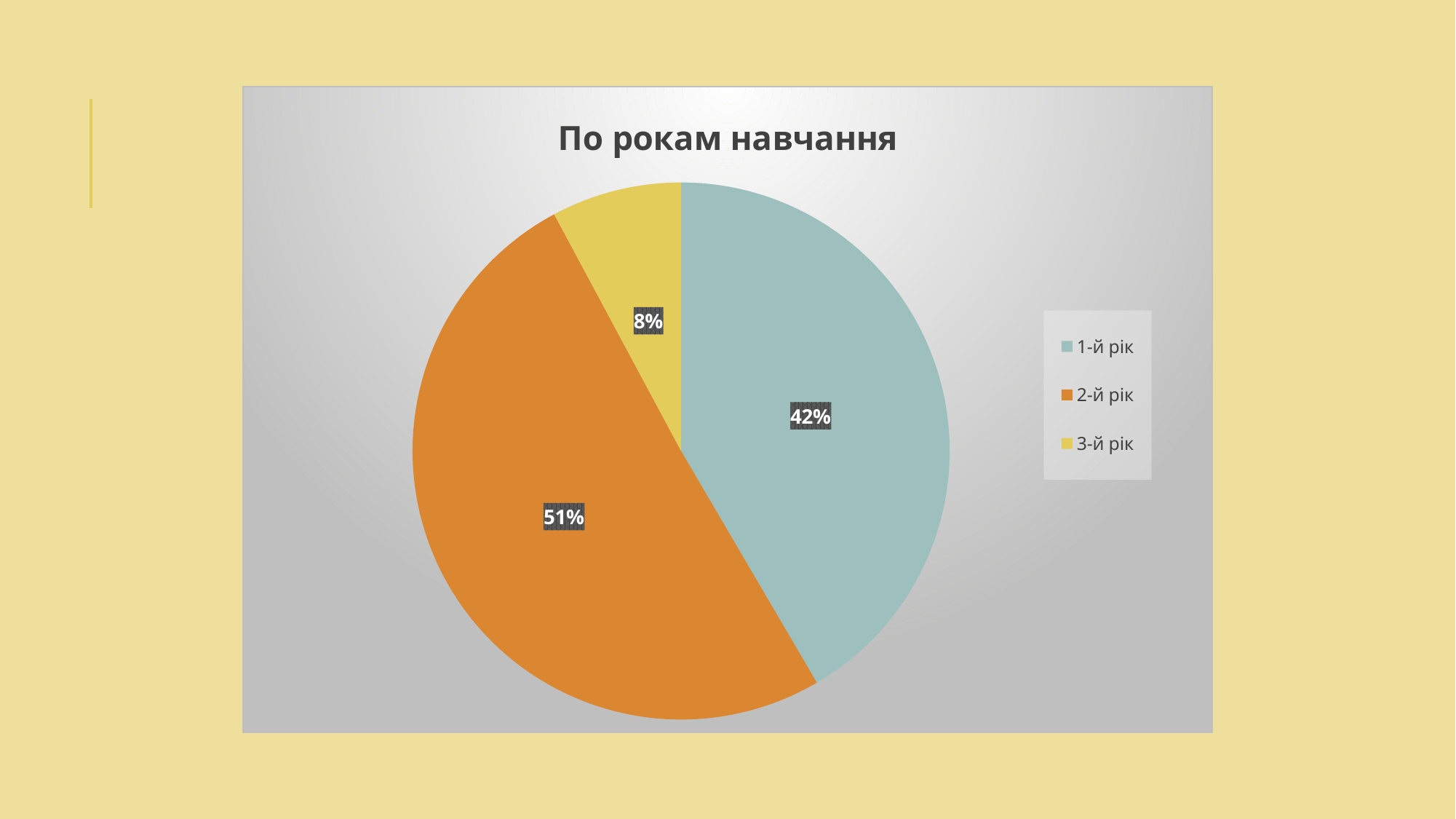
Which category has the smallest slice of the pie? 3-й рік What is the difference in percentage points between 2-й рік and 1-й рік? 9 What is the title of the chart? По рокам навчання Which category has the largest slice of the pie? 2-й рік How many entries does the legend list? 3 Which is larger, the share for 1-й рік or the share for 3-й рік? 1-й рік What share of the pie does 1-й рік have? 42% What share of the pie does 3-й рік have? 8% What type of chart is shown on the slide? pie chart What colour is the slice for 2-й рік? orange How many slices does the pie chart have? 3 What share of the pie does 2-й рік have? 51%